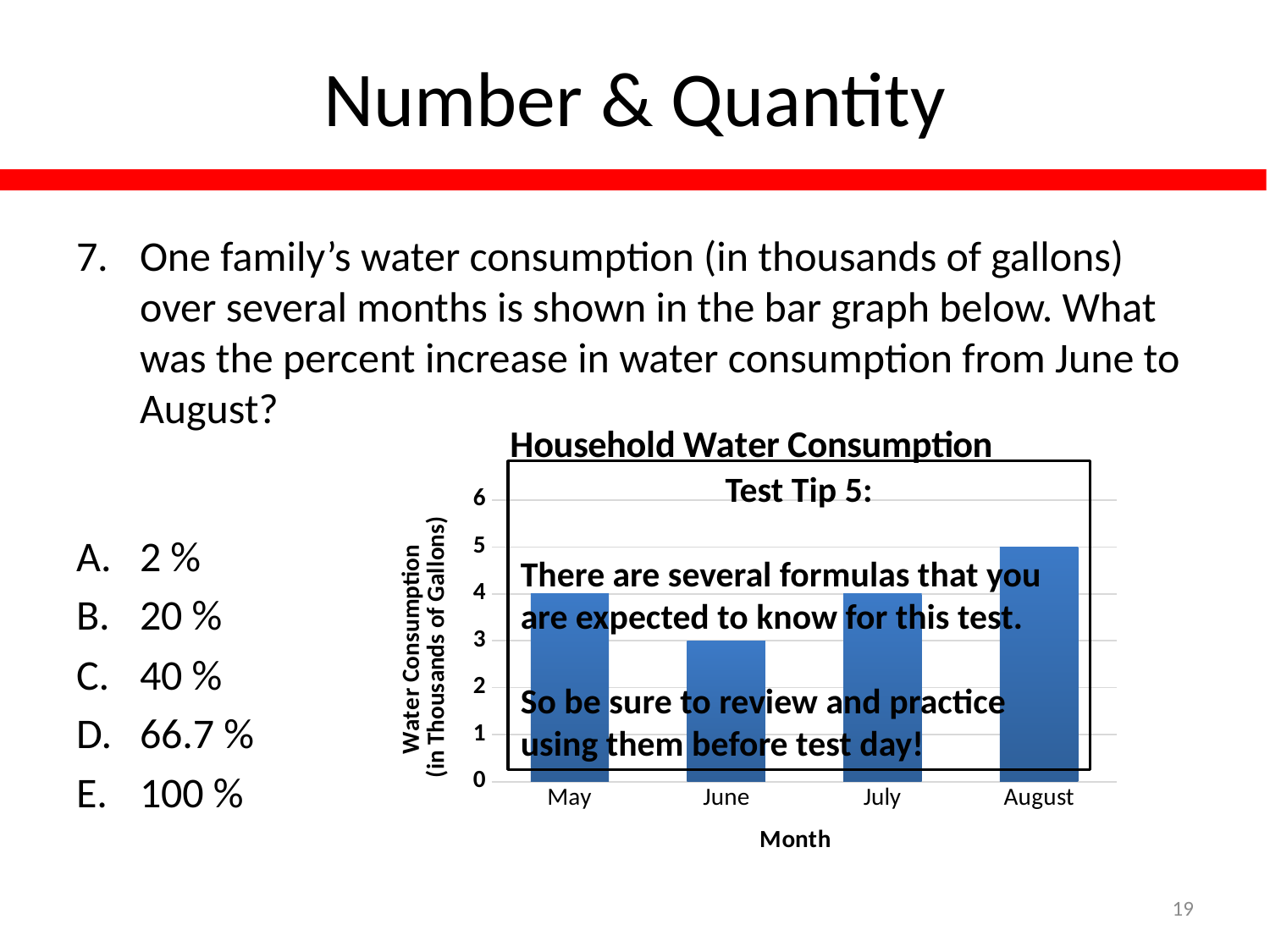
Which month has the lowest water consumption? June Which month has higher water consumption, July or June? July What is the difference in water consumption between August and June? 2 What is the label on the x axis of the chart? Month What is the title of the chart? Household Water Consumption What kind of chart is shown on the slide? bar chart Is the value for August greater or less than 4? greater What is the water consumption value for May? 4 Which month has the highest water consumption? August How many months are shown on the x axis of the chart? 4 What is the water consumption value for August? 5 What is the water consumption value for June? 3